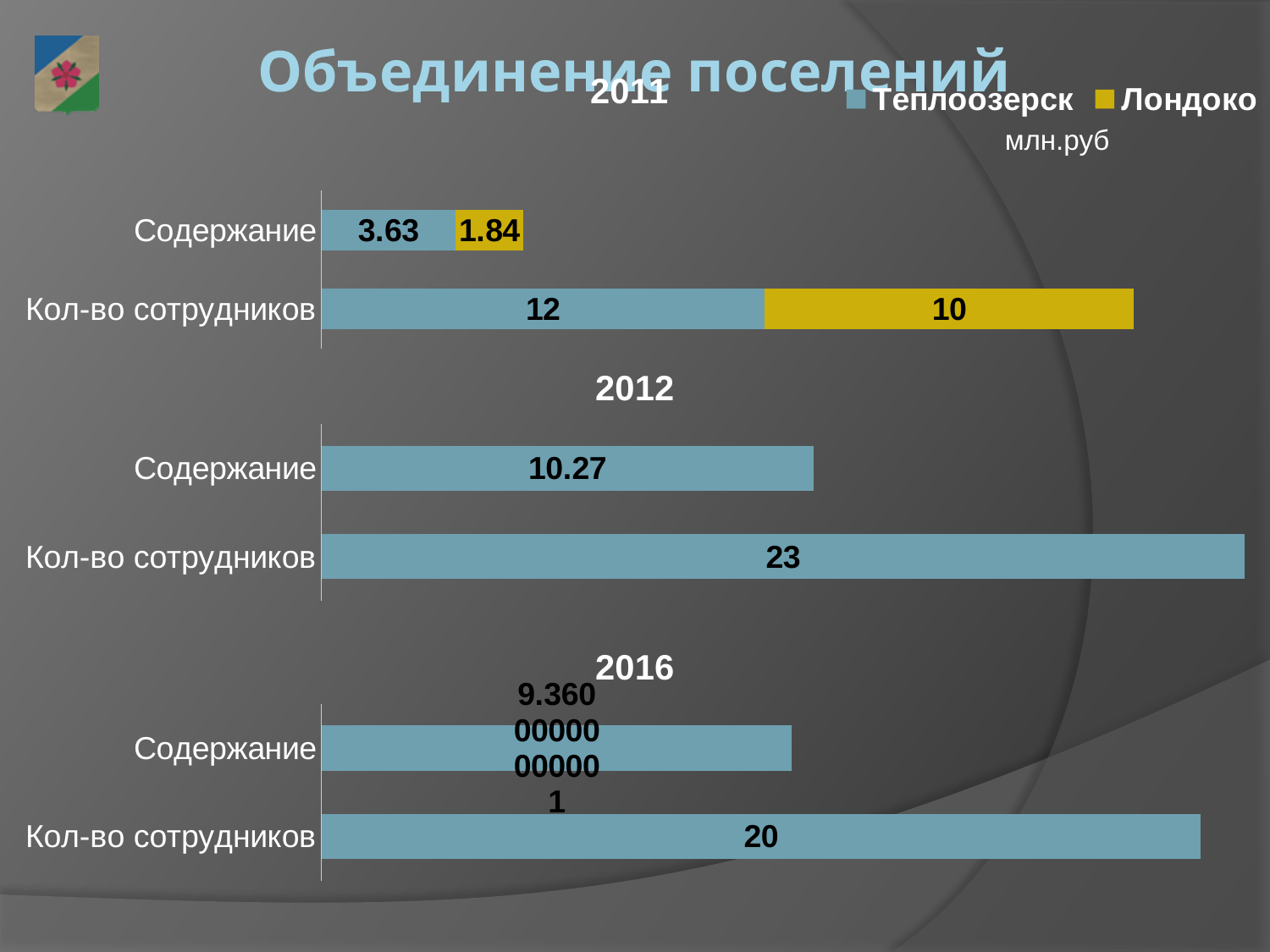
How many series does the legend at the top of the slide list? 2 In the 2011 chart, what is the value for Лондоко in the Содержание category? 1.84 In the 2011 chart, what is the total of the stacked bar for Содержание? 5.47 In the 2012 chart, what is the value for Содержание? 10.27 In the 2011 chart, what is the difference between Теплоозерск and Лондоко for Содержание? 1.79 In the 2011 chart, what is the value for Лондоко in the Кол-во сотрудников category? 10 In the 2011 chart, what is the total of the stacked bar for Кол-во сотрудников? 22 In the 2012 chart, what is the value for Кол-во сотрудников? 23 In the 2011 chart, which is larger for Кол-во сотрудников: Теплоозерск or Лондоко? Теплоозерск In the 2016 chart, what is the value for Кол-во сотрудников? 20 What kind of chart is the 2012 chart? bar chart In the 2011 chart, what is the value for Теплоозерск in the Содержание category? 3.63